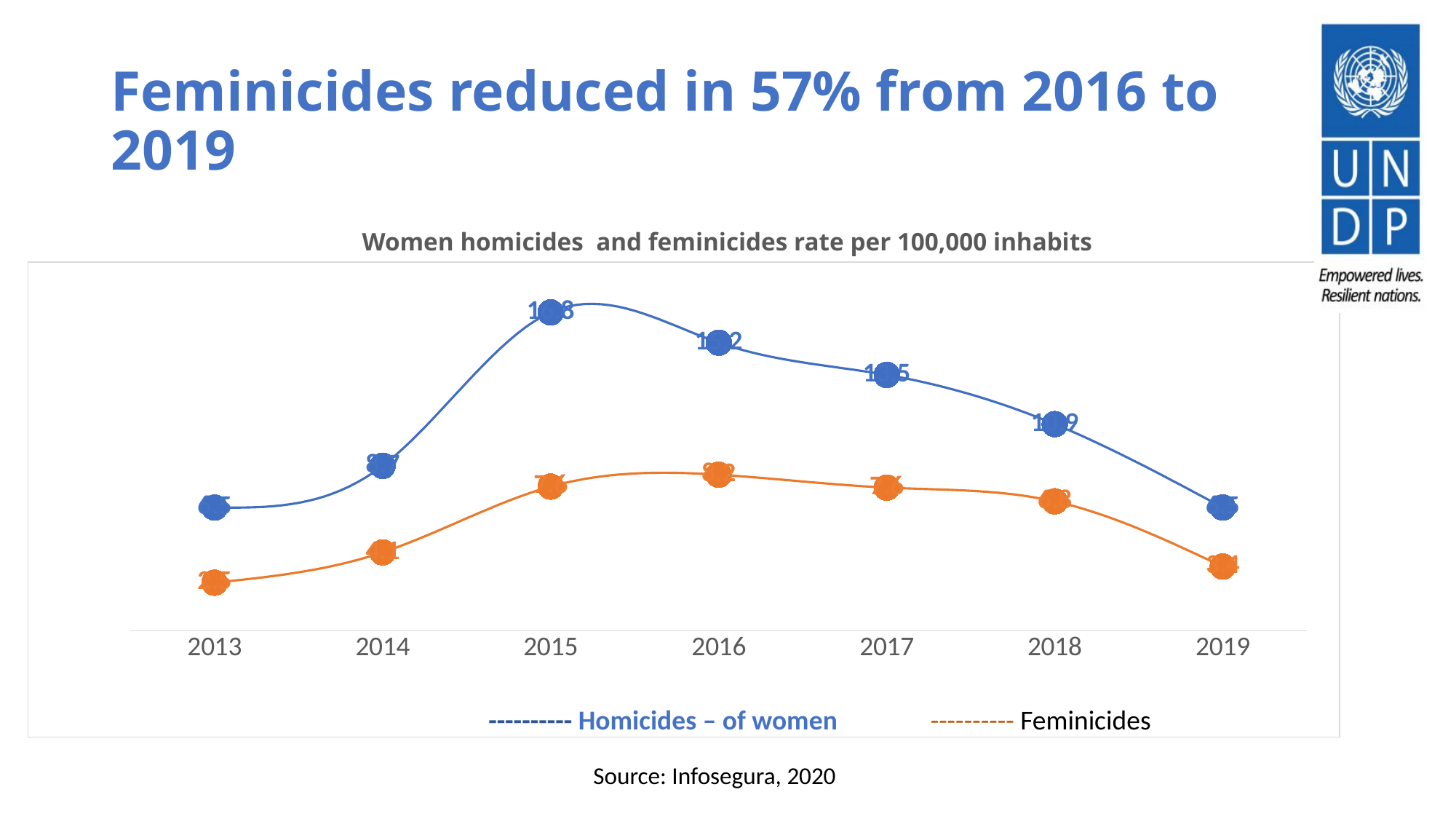
Does the Feminicides series rise or fall from 2013 to 2016? Rise Which colour represents the Feminicides series? Orange In which year does the Homicides – of women series reach its highest value? 2015 What kind of chart is shown on the slide? Line chart In which year is the Feminicides series at its lowest value? 2013 How many series does the legend list? 2 What is the title of the chart? Women homicides and feminicides rate per 100,000 inhabits How many years are plotted along the x axis? 7 Which is higher for Homicides – of women: the value in 2014 or the value in 2018? 2018 Which is higher for Feminicides: the value in 2014 or the value in 2018? 2018 Does the Homicides – of women series rise or fall from 2015 to 2019? Fall Which is higher for Homicides – of women: the value in 2015 or the value in 2016? 2015